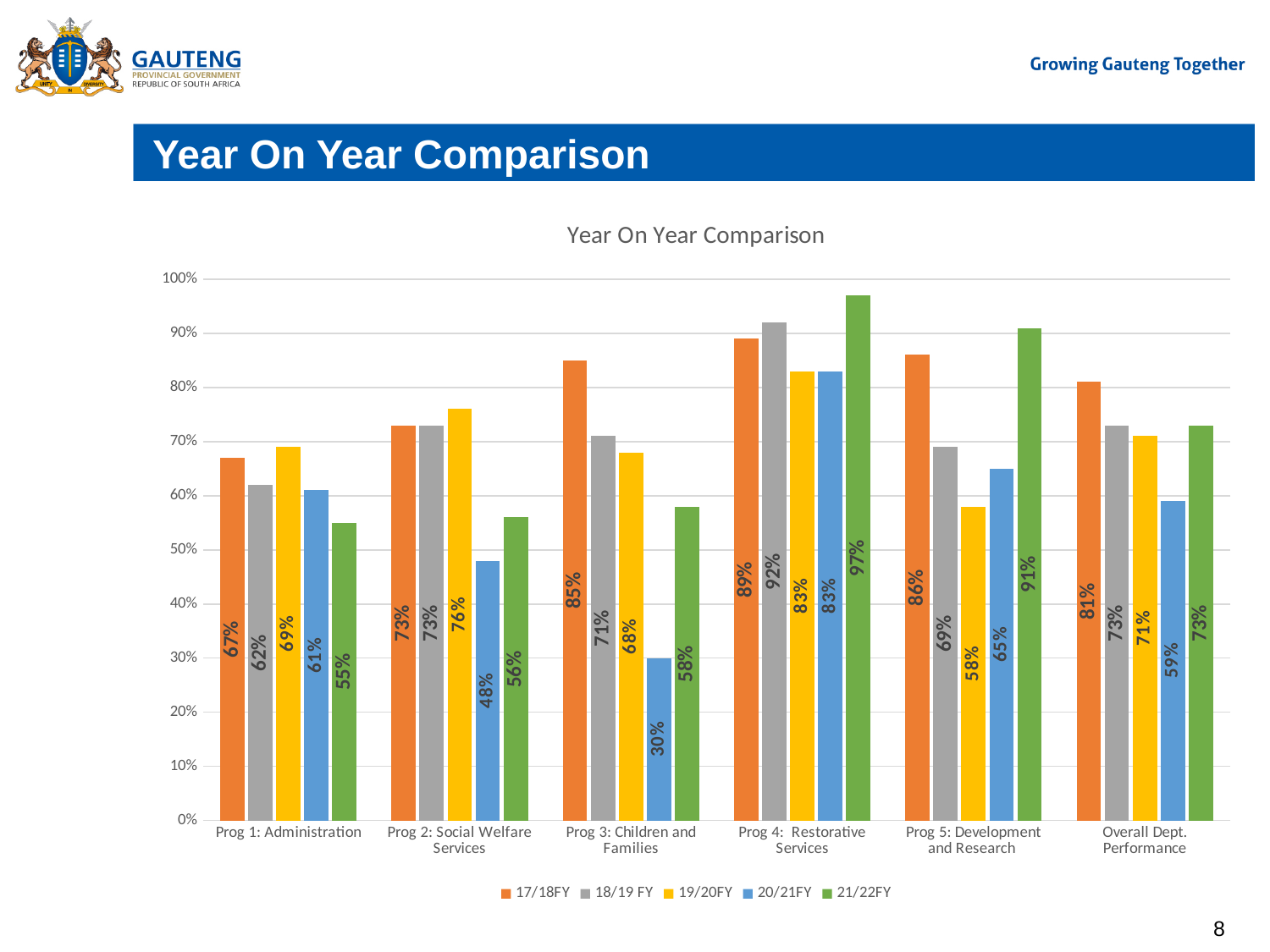
Which category has the lowest 20/21FY value? Prog 3: Children and Families Do the values for Prog 3: Children and Families rise or fall from 17/18FY to 20/21FY? Fall What is the 21/22FY value for Prog 4: Restorative Services? 97% How many categories are shown on the x axis? 6 What is the 17/18FY value for Overall Dept. Performance? 81% What is the 20/21FY value for Prog 3: Children and Families? 30% Which is larger for Prog 1: Administration, the 19/20FY value or the 21/22FY value? 19/20FY What is the title of the chart? Year On Year Comparison What kind of chart is shown on the slide? Bar chart What is the difference between the 21/22FY and 17/18FY values for Prog 5: Development and Research? 5% Which category has the highest 21/22FY value? Prog 4: Restorative Services How many series does the legend list? 5